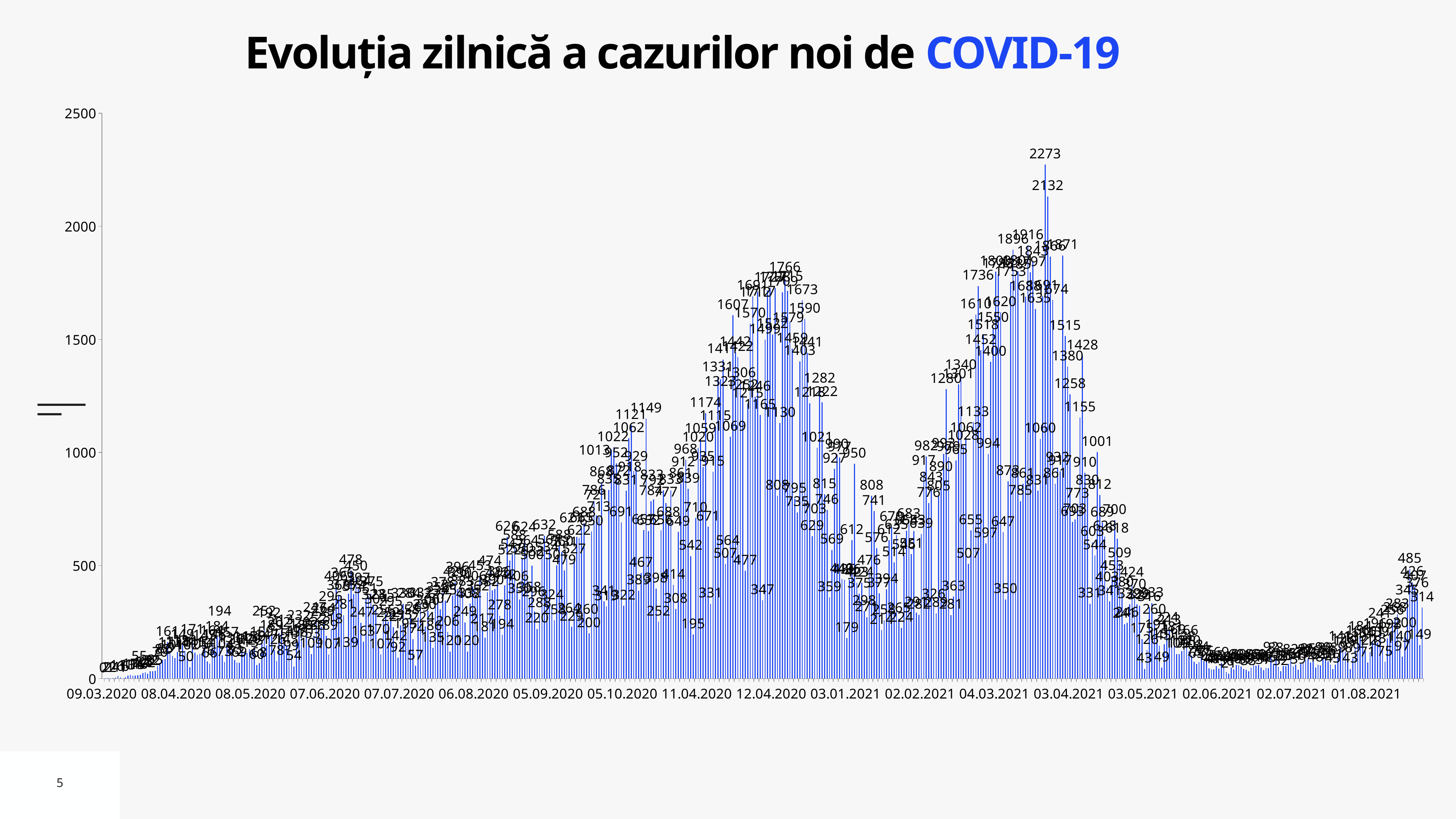
Is the highest bar on the chart greater or less than 2000? greater What is the highest value labeled on the chart? 2273 What is the title of the chart? Evoluția zilnică a cazurilor noi de COVID-19 What is the difference between the two highest labeled values, 2273 and 2132? 141 What kind of chart is shown on the slide? bar chart Is the highest bar in the peak near 12.04.2020 greater or less than 2000? less Do the values rise or fall between 03.04.2021 and 02.06.2021? fall What is the highest tick value shown on the vertical axis? 2500 Is the highest bar in the final rise near 01.08.2021 greater or less than 1000? less Do the values rise or fall between 09.03.2020 and 08.04.2020? rise Which is larger, the peak labeled 2273 or the peak labeled 1766? 2273